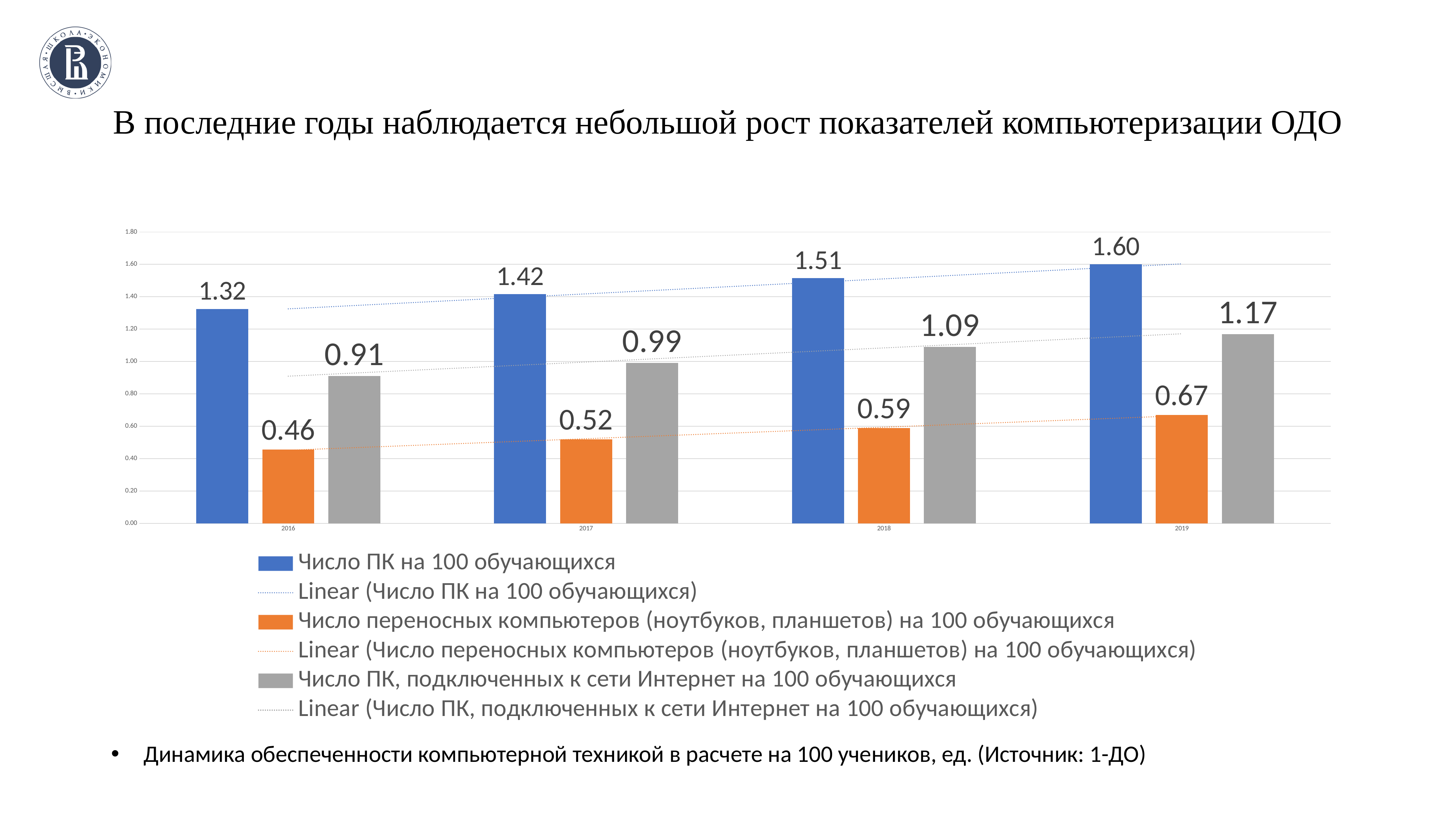
What is the value of 'Число ПК на 100 обучающихся' in 2019? 1.60 What kind of chart is shown on the slide? bar chart How many entries does the legend list? 6 Which is larger in 2017: 'Число ПК, подключенных к сети Интернет на 100 обучающихся' or 'Число переносных компьютеров (ноутбуков, планшетов) на 100 обучающихся'? Число ПК, подключенных к сети Интернет на 100 обучающихся Do the values of 'Число переносных компьютеров (ноутбуков, планшетов) на 100 обучающихся' rise or fall from 2016 to 2019? rise Is the value for 'Число ПК, подключенных к сети Интернет на 100 обучающихся' in 2019 greater or less than 1.00? greater In which year is 'Число ПК на 100 обучающихся' the highest? 2019 What is the value of 'Число переносных компьютеров (ноутбуков, планшетов) на 100 обучающихся' in 2016? 0.46 In which year is 'Число переносных компьютеров (ноутбуков, планшетов) на 100 обучающихся' the lowest? 2016 What is the difference between 'Число ПК на 100 обучающихся' in 2019 and in 2016? 0.28 What is the value of 'Число ПК, подключенных к сети Интернет на 100 обучающихся' in 2018? 1.09 How many years are shown on the x axis? 4